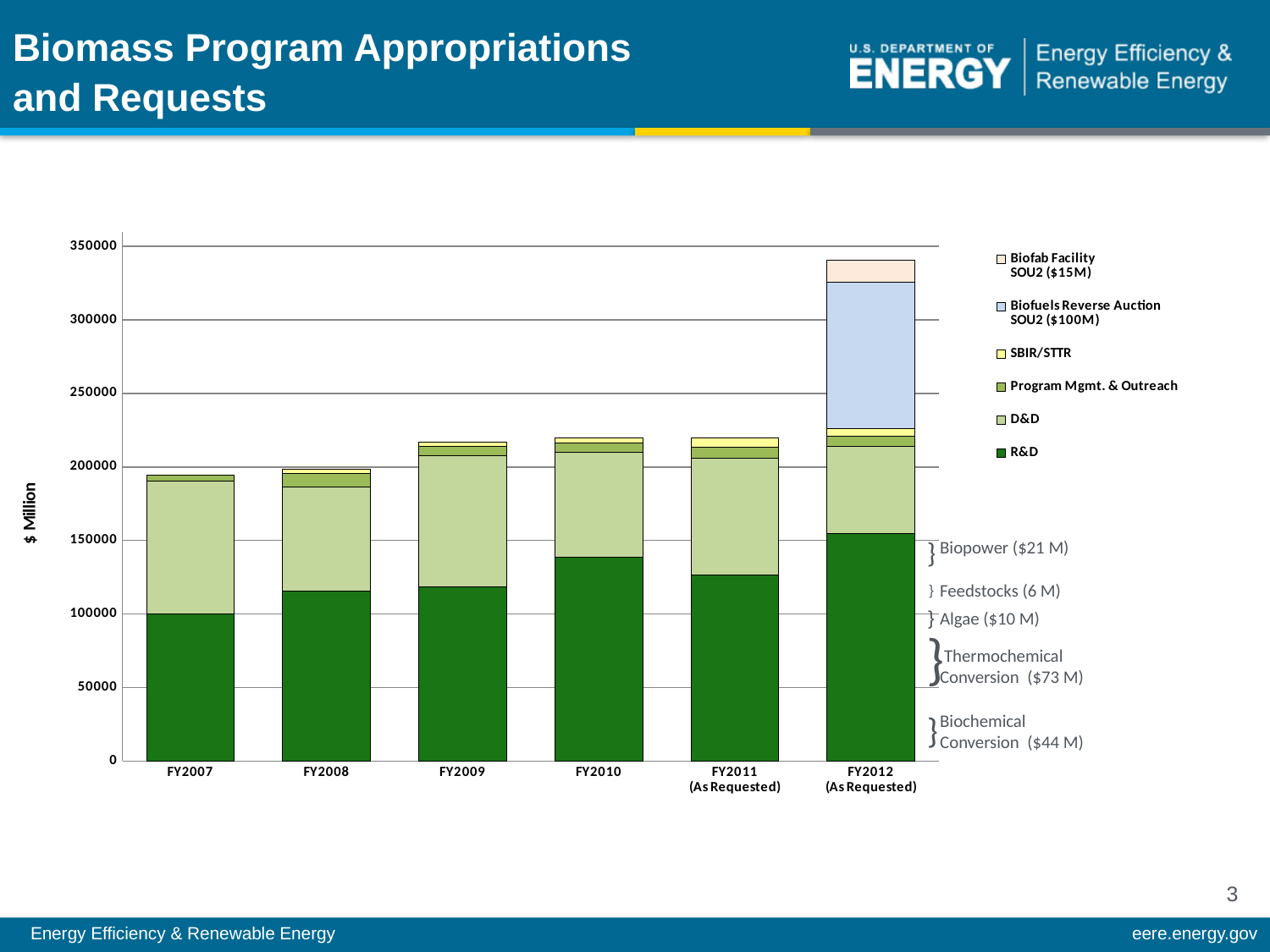
How many series does the chart's legend list? 6 What kind of chart is shown on the slide? stacked bar chart How many fiscal years are shown along the x axis of the chart? 6 Which has a larger total, FY2012 (As Requested) or FY2007? FY2012 (As Requested) Is the R&D value for FY2010 greater or less than 150000? less Is the total for FY2012 (As Requested) greater or less than 300000? greater Which fiscal year has the tallest stacked bar in the chart? FY2012 (As Requested) Is the total for FY2009 greater or less than 200000? greater Which fiscal year has the smallest R&D segment in the chart? FY2007 Does the R&D segment rise or fall from FY2007 to FY2012 (As Requested)? rise What is the label on the chart's y axis? $ Million